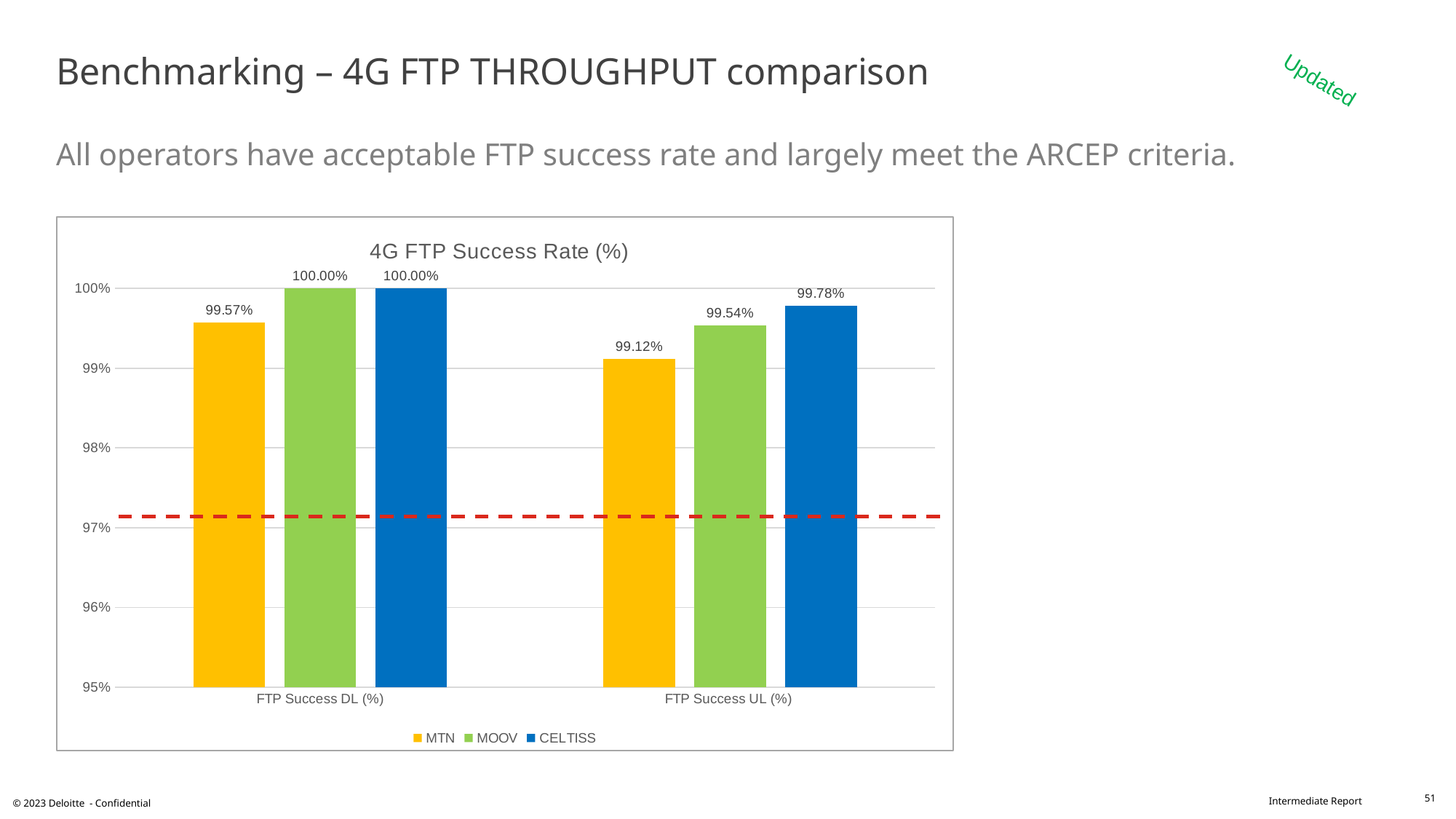
Which is larger: MTN's FTP Success DL (%) or MTN's FTP Success UL (%)? FTP Success DL (%) What is the FTP Success UL (%) value for MOOV? 99.54% What is the difference between MOOV and MTN for FTP Success DL (%)? 0.43% What kind of chart is shown on the slide? Bar chart What is the FTP Success UL (%) value for CELTISS? 99.78% What is the FTP Success DL (%) value for MTN? 99.57% What is the title of the chart? 4G FTP Success Rate (%) What is the difference between CELTISS and MTN for FTP Success UL (%)? 0.66% Is the FTP Success UL (%) value for MTN greater or less than 99%? greater Which operator has the lowest FTP Success UL (%)? MTN How many series does the legend list? 3 Which operator has the highest FTP Success UL (%)? CELTISS